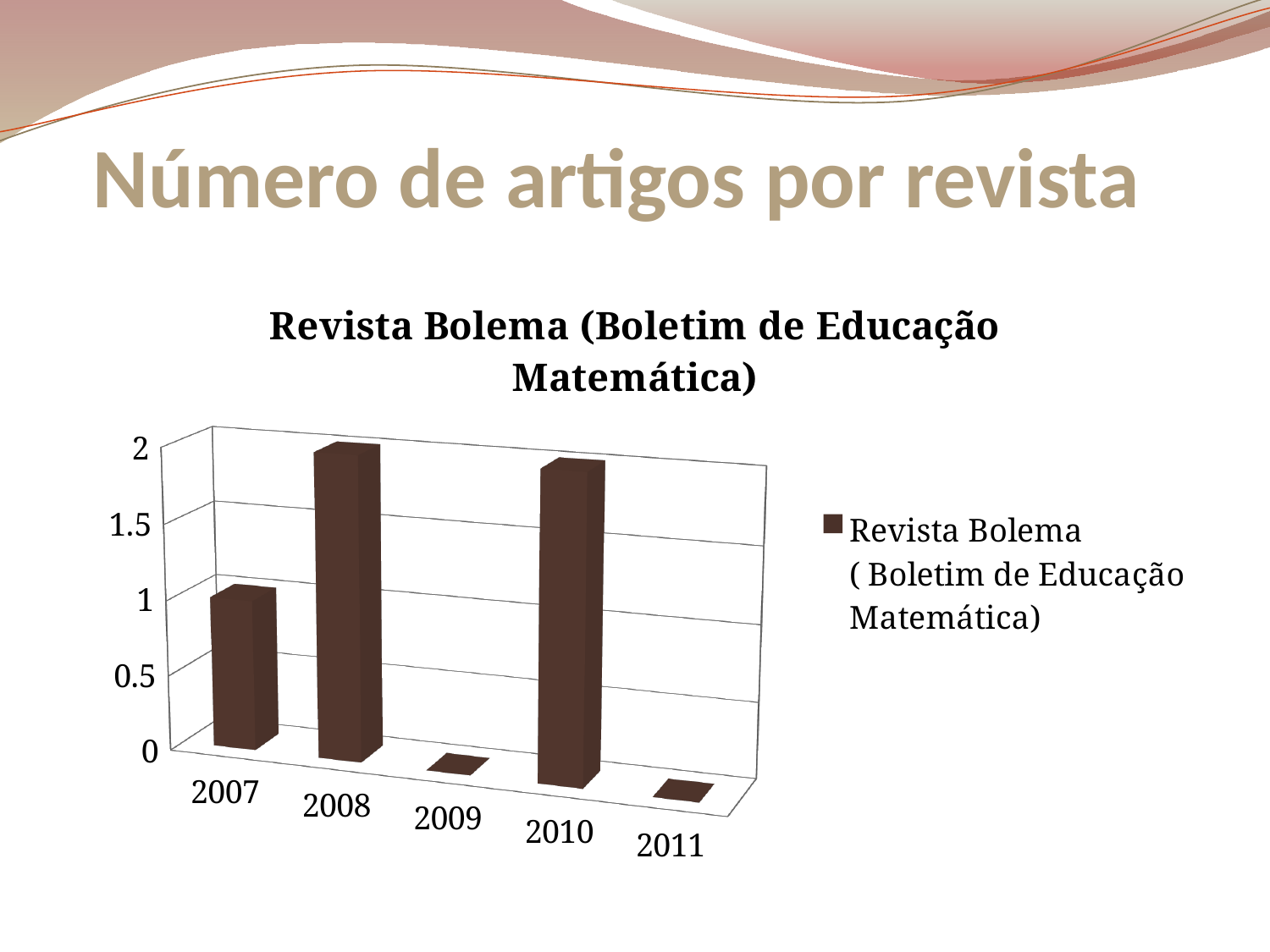
What is the title of the chart? Revista Bolema (Boletim de Educação Matemática) What is the value for 2009? 0 Is the value for 2007 greater or less than 1.5? less How many series does the chart's legend list? 1 Is the value for 2008 greater or less than 1.5? greater What is the value for 2011? 0 How many years are shown on the x axis of the chart? 5 Is the value for 2010 greater or less than 1? greater What kind of chart is shown on the slide? bar chart What is the value for 2007? 1 Which year has the larger value, 2007 or 2008? 2008 Which year has the larger value, 2010 or 2011? 2010